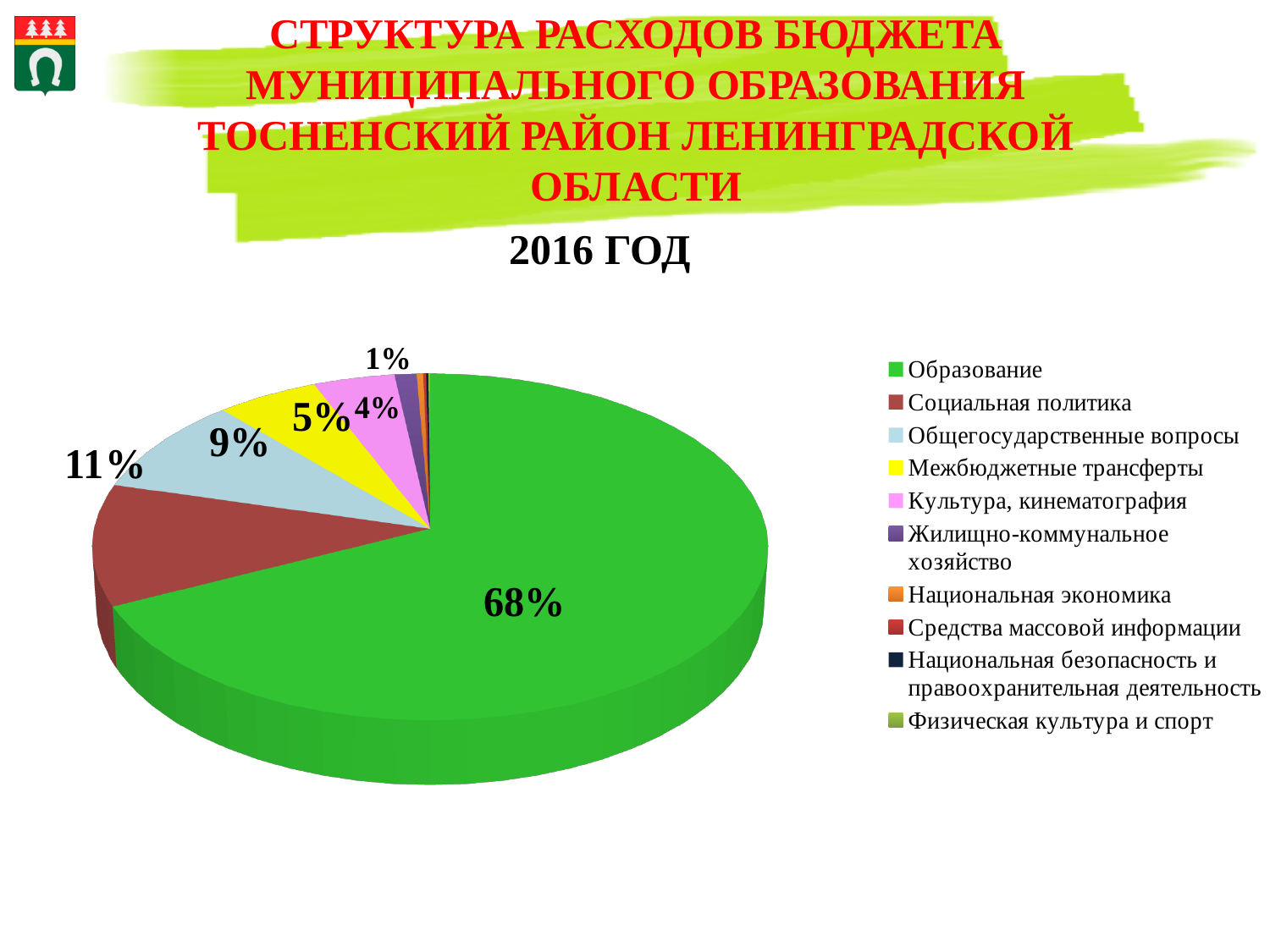
What type of chart is shown on the slide? Pie chart By how many percentage points does Образование exceed Социальная политика? 57% Which category has the largest slice of the pie chart? Образование What percentage is shown for Общегосударственные вопросы? 9% What percentage is shown for Культура, кинематография? 4% What share of budget expenditure does Образование account for in the pie chart? 68% What is the difference between the shares of Социальная политика and Культура, кинематография? 7% How many categories are listed in the chart legend? 10 What percentage is shown for Социальная политика? 11% Which is larger: Общегосударственные вопросы or Межбюджетные трансферты? Общегосударственные вопросы Which year does the chart on the slide refer to? 2016 What percentage is shown for Межбюджетные трансферты? 5%